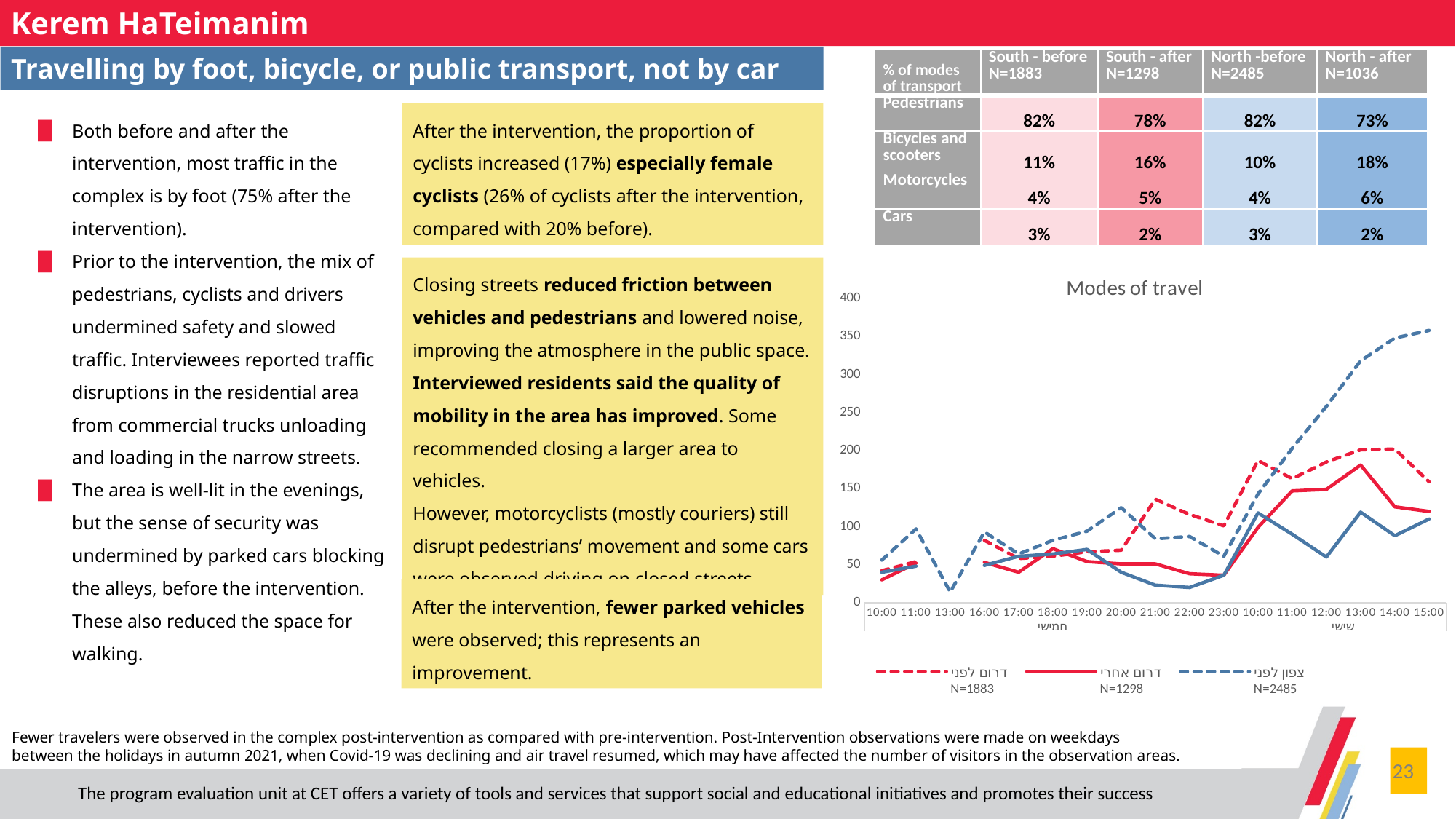
In the "Modes of travel" chart, is the value of the צפון לפני N=2485 series at 13:00 on חמישי greater or less than 50? less What is the title of the line chart on the slide? Modes of travel How many series does the legend of the "Modes of travel" chart list? 3 In the "Modes of travel" chart, is the value of the דרום לפני N=1883 series at 10:00 on שישי greater or less than 150? greater What kind of chart is the "Modes of travel" chart? line chart In the "Modes of travel" chart, at 15:00 on שישי, which series has the larger value: צפון לפני N=2485 or דרום אחרי N=1298? צפון לפני N=2485 How many time points are plotted along the x axis of the "Modes of travel" chart? 17 In the "Modes of travel" chart, which series reaches the highest value? צפון לפני N=2485 In the "Modes of travel" chart, does the צפון לפני N=2485 series rise or fall from 10:00 to 15:00 on שישי? rise What is the highest value shown on the y axis of the "Modes of travel" chart? 400 In the "Modes of travel" chart, is the value of the צפון לפני N=2485 series at 15:00 on שישי greater or less than 300? greater